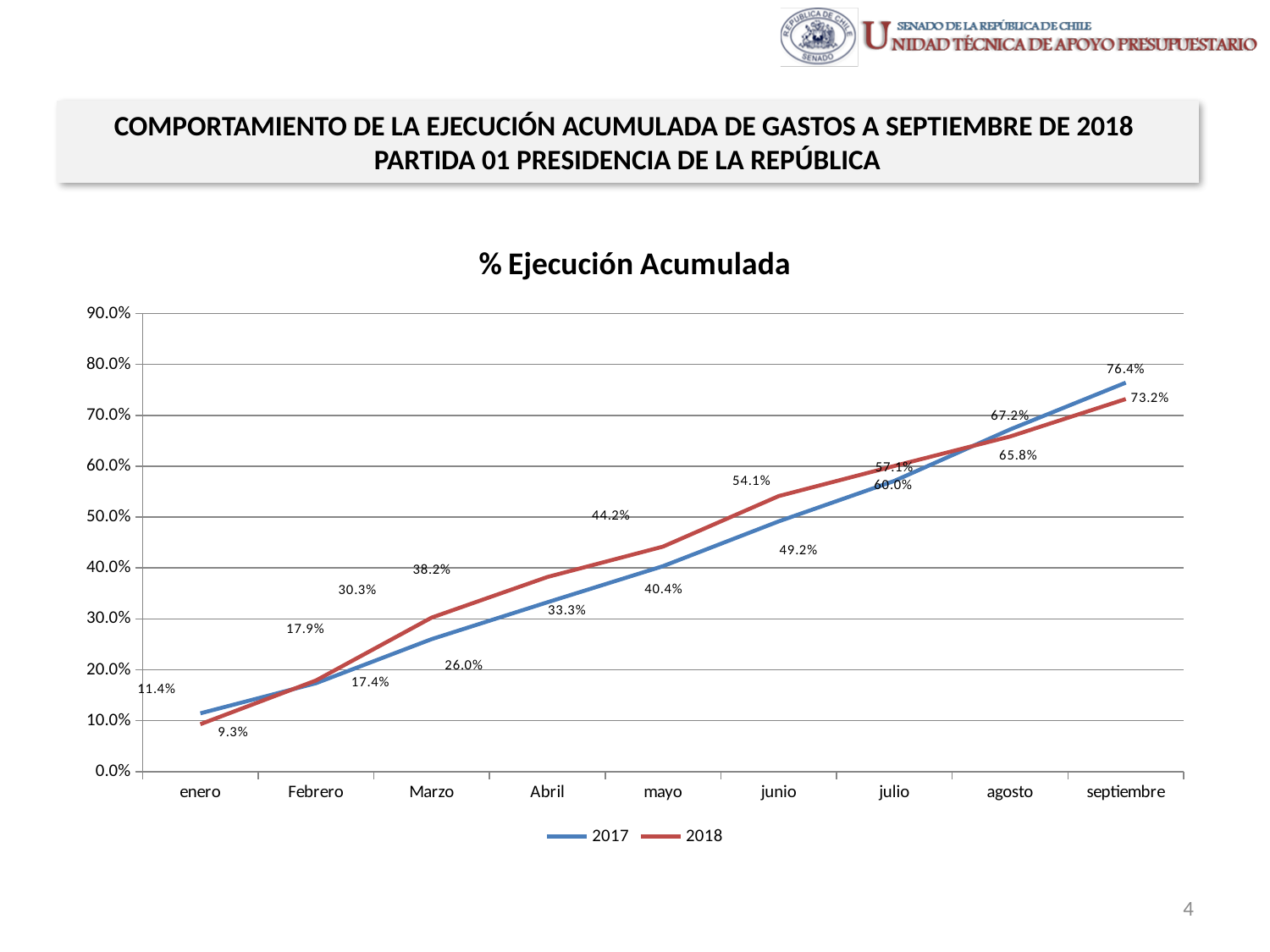
What are the two entries in the legend? 2017 and 2018 How many months are plotted along the x axis? 9 How many series does the legend list? 2 In Abril, which series has the higher value, 2017 or 2018? 2018 Do the values for 2017 rise or fall from enero to septiembre? Rise What is the value for 2017 in mayo? 40.4% What is the value for 2017 in septiembre? 76.4% What is the value for 2018 in enero? 9.3% What is the value for 2018 in Marzo? 30.3% What kind of chart is shown on the slide? Line chart In which month does the 2018 series reach its lowest value? enero What is the difference between the 2017 and 2018 values in septiembre? 3.2 percentage points